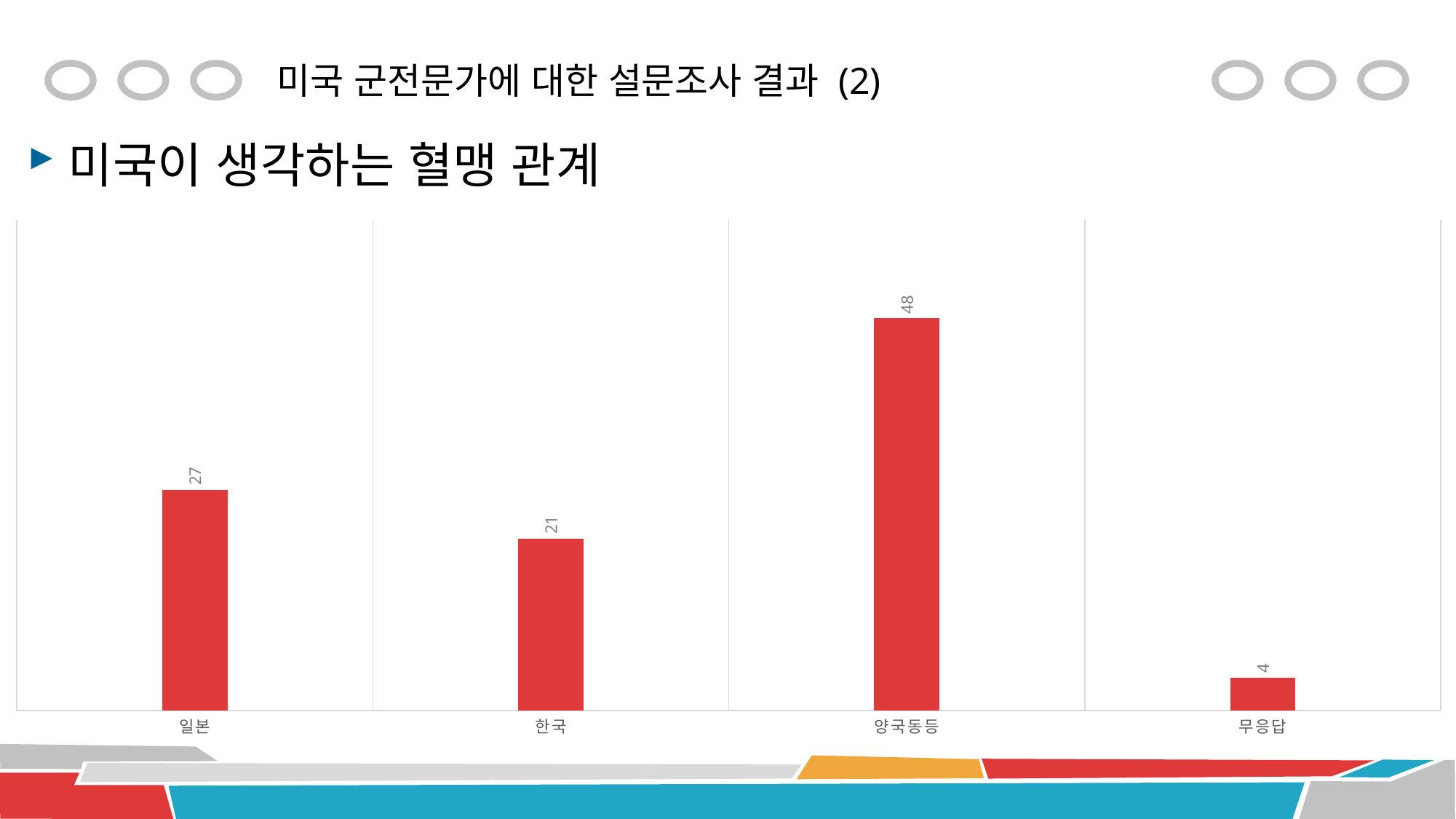
What is the value for 일본? 27 What kind of chart is shown on the slide? bar chart What is the value for 한국? 21 What is the value for 무응답? 4 What is the difference between the values for 일본 and 한국? 6 What colour are the bars in the chart? red Which category has the lowest value? 무응답 What is the value for 양국동등? 48 What is the difference between the values for 양국동등 and 일본? 21 Which category has the highest value? 양국동등 How many categories are shown on the x axis? 4 Which is larger, the value for 일본 or the value for 한국? 일본